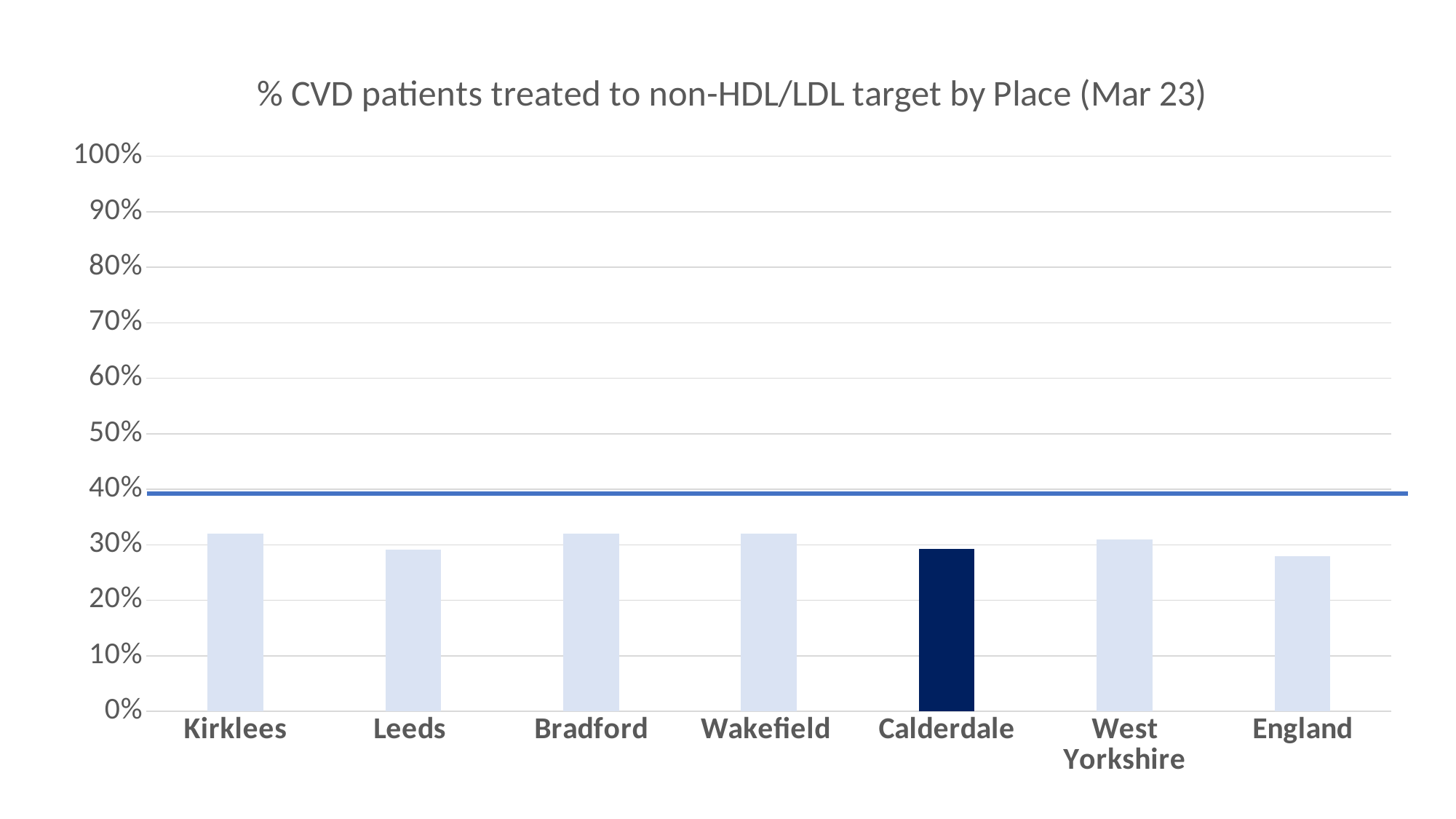
What kind of chart is shown on the slide? bar chart How many places (categories) are shown on the x axis of the chart? 7 Is the value for West Yorkshire greater or less than 20%? greater Which has the larger value, Bradford or England? Bradford What is the title of the chart? % CVD patients treated to non-HDL/LDL target by Place (Mar 23) Is the value for Kirklees greater or less than 30%? greater Is the value for England greater or less than 30%? less Which has the larger value, Kirklees or England? Kirklees Which category's bar is drawn in a dark navy colour, unlike the others? Calderdale